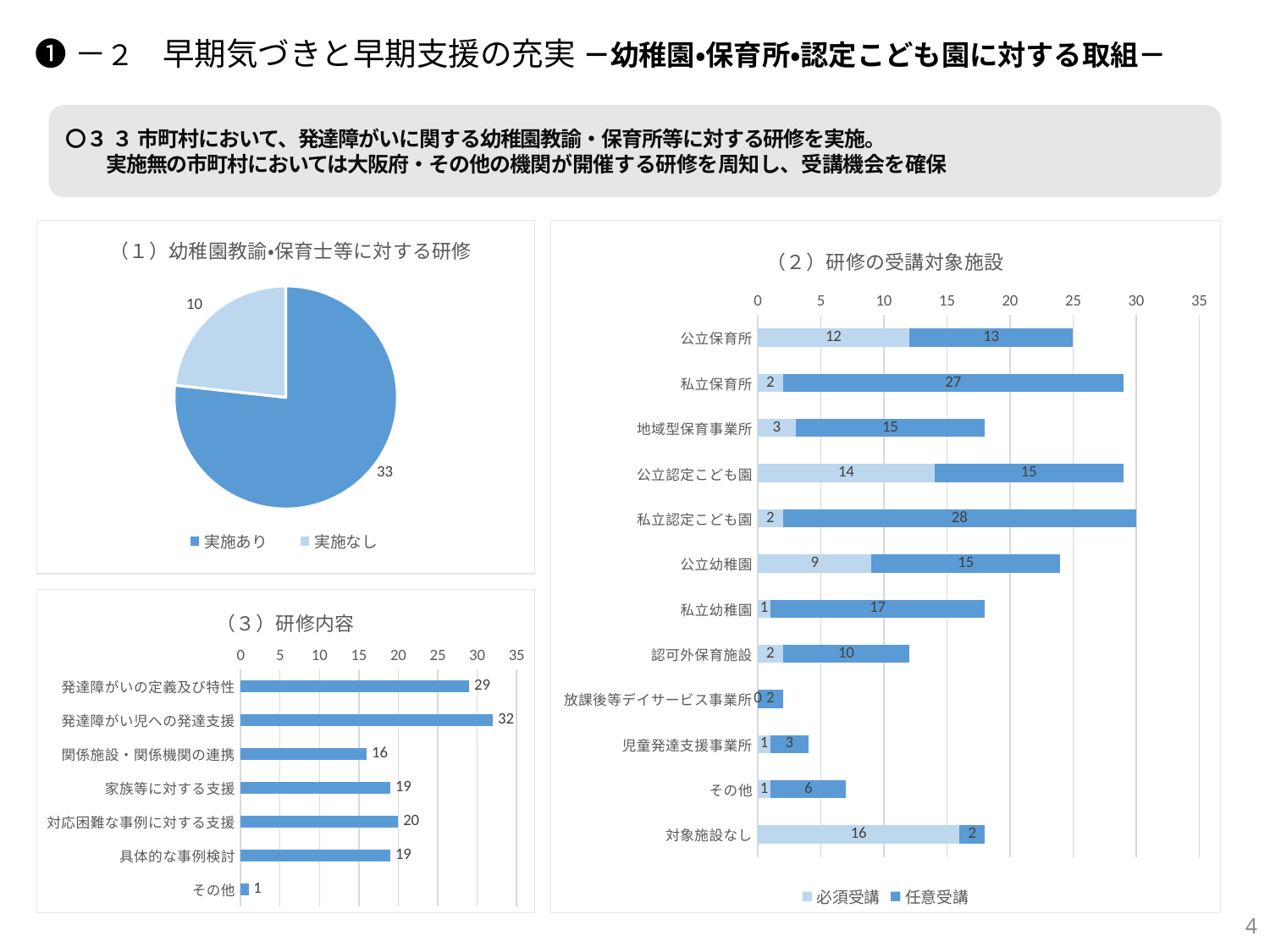
In the chart titled （３）研修内容, which is larger: 対応困難な事例に対する支援 or 家族等に対する支援? 対応困難な事例に対する支援 In the chart titled （３）研修内容, which category has the lowest value? その他 In the chart titled （２）研修の受講対象施設, what is the 任意受講 value for 私立認定こども園? 28 In the chart titled （２）研修の受講対象施設, what is the total of the stacked bar for 公立保育所? 25 In the chart titled （１）幼稚園教諭•保育士等に対する研修, what is the value for 実施あり? 33 In the chart titled （３）研修内容, what is the difference between 発達障がいの定義及び特性 and 関係施設・関係機関の連携? 13 In the chart titled （２）研修の受講対象施設, how many categories are shown? 12 In the chart titled （２）研修の受講対象施設, what is the 必須受講 value for 対象施設なし? 16 In the chart titled （１）幼稚園教諭•保育士等に対する研修, what is the value for 実施なし? 10 In the chart titled （２）研修の受講対象施設, how many series does the legend list? 2 What kind of chart is （１）幼稚園教諭•保育士等に対する研修? pie chart In the chart titled （３）研修内容, which category has the highest value? 発達障がい児への発達支援